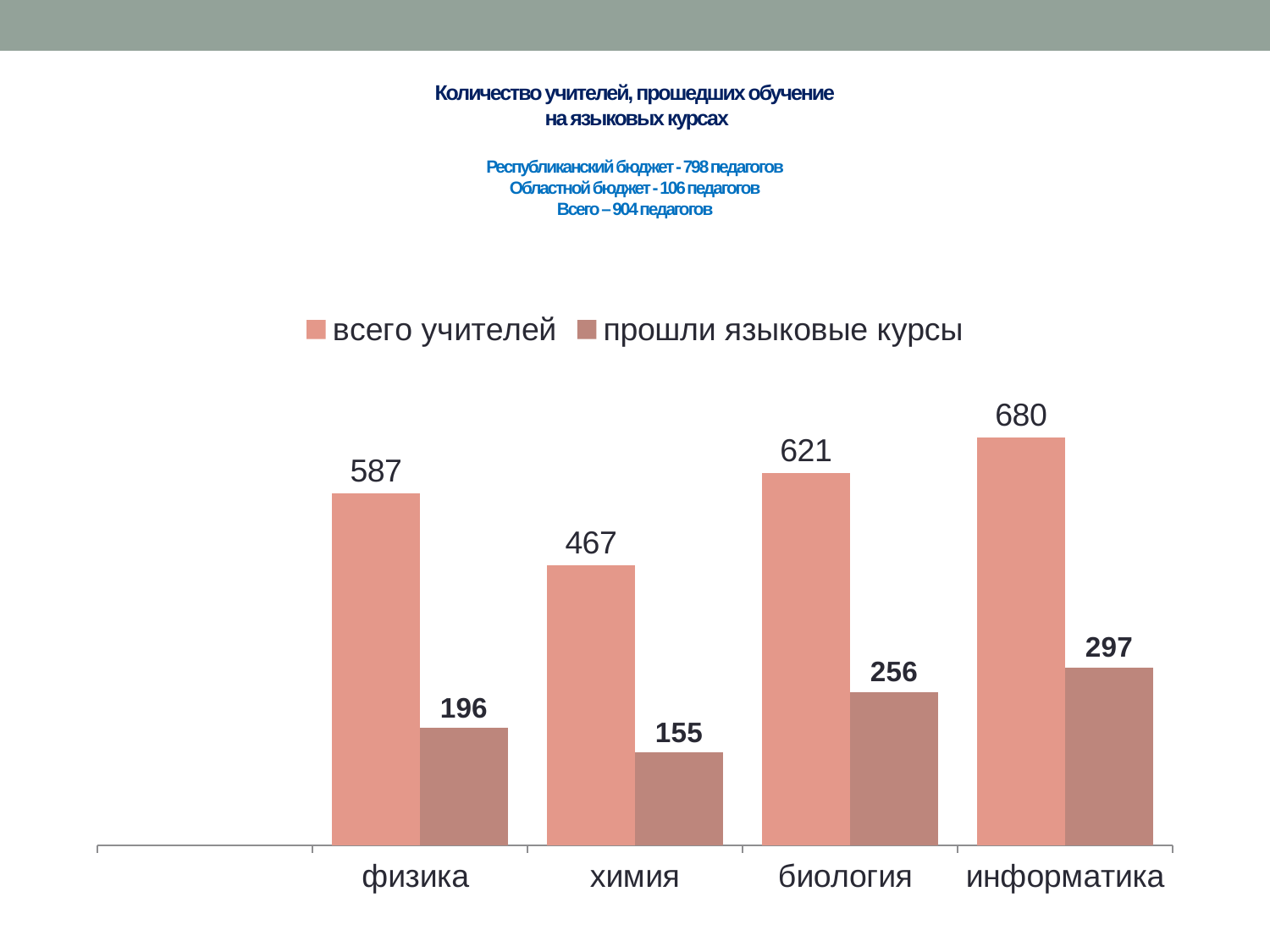
Which category has the lowest value for 'прошли языковые курсы'? химия How many series does the legend list? 2 Which category has the highest value for 'всего учителей'? информатика What is the difference between 'всего учителей' and 'прошли языковые курсы' for биология? 365 What is the value of 'прошли языковые курсы' for информатика? 297 How many categories are shown on the x axis? 4 What is the value of 'прошли языковые курсы' for химия? 155 What kind of chart is shown on the slide? bar chart What is the title of the chart? Количество учителей, прошедших обучение на языковых курсах Which is larger: 'прошли языковые курсы' for физика or for биология? биология What is the value of 'всего учителей' for физика? 587 What is the difference in 'всего учителей' between информатика and химия? 213